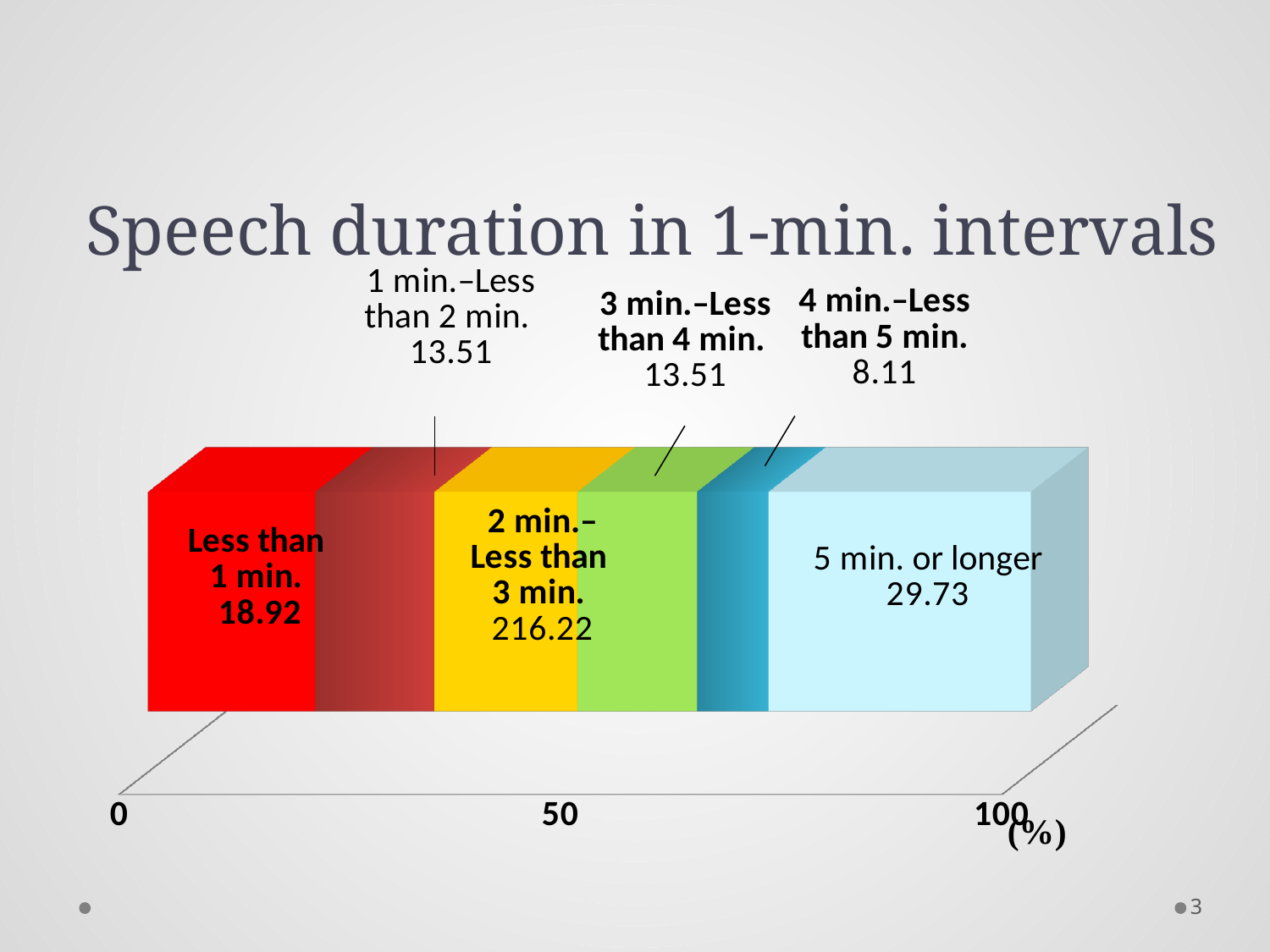
What is the value for the '5 min. or longer' segment? 29.73 What value is printed for the '2 min.–Less than 3 min.' segment? 216.22 What is the title of the chart? Speech duration in 1-min. intervals What is the value for the '1 min.–Less than 2 min.' segment? 13.51 Which interval has the lowest value? 4 min.–Less than 5 min. Which is larger, the value for '5 min. or longer' or the value for 'Less than 1 min.'? 5 min. or longer What is the value for the '4 min.–Less than 5 min.' segment? 8.11 What is the difference between the '5 min. or longer' value and the 'Less than 1 min.' value? 10.81 What is the difference between the 'Less than 1 min.' value and the '1 min.–Less than 2 min.' value? 5.41 How many duration intervals (segments) are shown in the bar? 6 What kind of chart is shown on the slide? Stacked bar chart What is the value for the 'Less than 1 min.' segment? 18.92